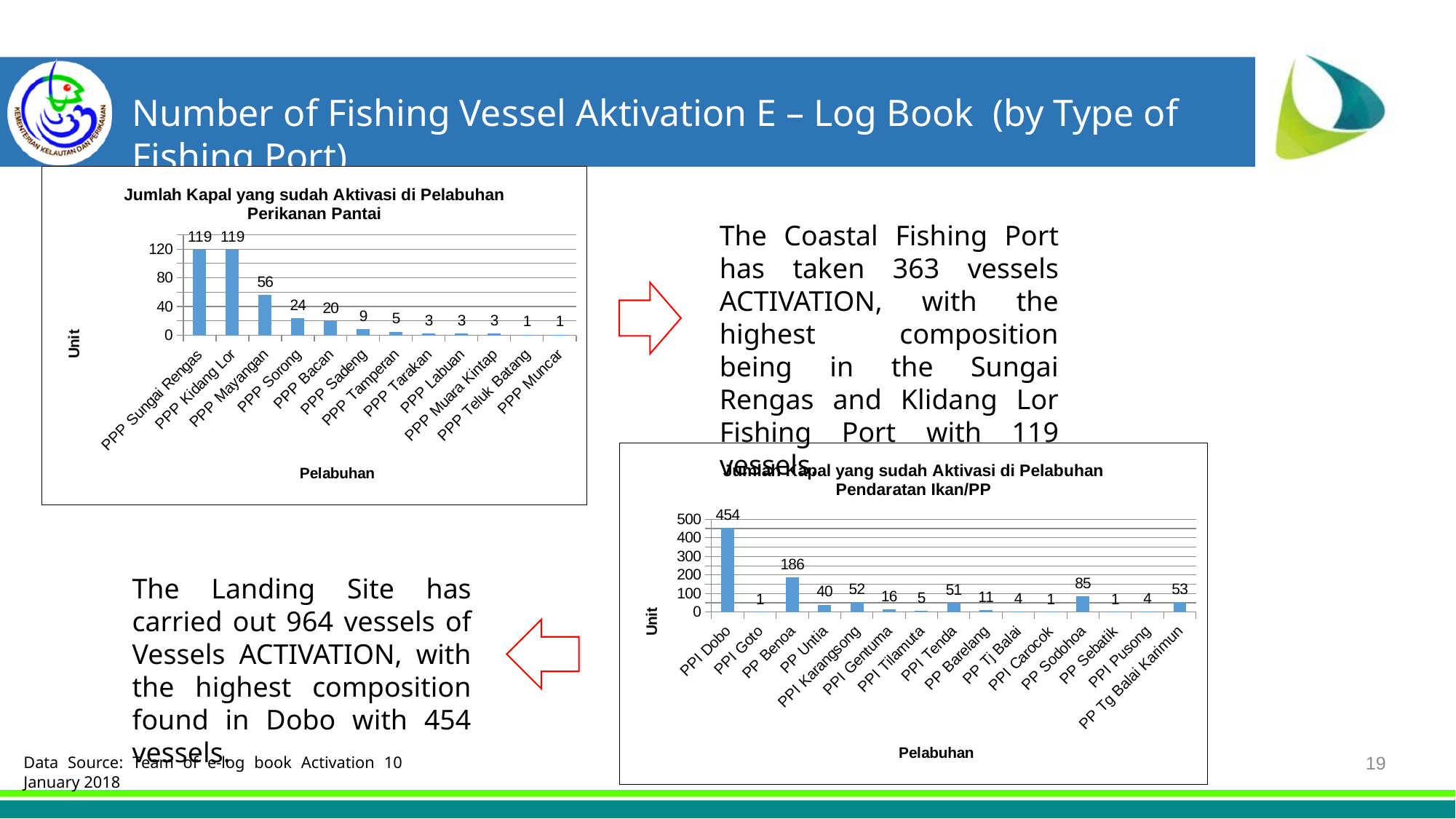
In the chart titled 'Jumlah Kapal yang sudah Aktivasi di Pelabuhan Pendaratan Ikan/PP', what is the value for PP Benoa? 186 How many ports are shown in the chart titled 'Jumlah Kapal yang sudah Aktivasi di Pelabuhan Perikanan Pantai'? 12 What is the x-axis title of the chart titled 'Jumlah Kapal yang sudah Aktivasi di Pelabuhan Pendaratan Ikan/PP'? Pelabuhan In the chart titled 'Jumlah Kapal yang sudah Aktivasi di Pelabuhan Perikanan Pantai', what is the value for PPP Sorong? 24 In the chart titled 'Jumlah Kapal yang sudah Aktivasi di Pelabuhan Perikanan Pantai', what is the value for PPP Mayangan? 56 In the chart titled 'Jumlah Kapal yang sudah Aktivasi di Pelabuhan Perikanan Pantai', what is the difference between PPP Sungai Rengas and PPP Mayangan? 63 In the chart titled 'Jumlah Kapal yang sudah Aktivasi di Pelabuhan Pendaratan Ikan/PP', what is the difference between PPI Dobo and PP Benoa? 268 In the chart titled 'Jumlah Kapal yang sudah Aktivasi di Pelabuhan Perikanan Pantai', which is larger, PPP Bacan or PPP Sadeng? PPP Bacan What type of chart is the chart titled 'Jumlah Kapal yang sudah Aktivasi di Pelabuhan Perikanan Pantai'? Bar chart In the chart titled 'Jumlah Kapal yang sudah Aktivasi di Pelabuhan Pendaratan Ikan/PP', what is the value for PP Sodohoa? 85 How many ports are shown in the chart titled 'Jumlah Kapal yang sudah Aktivasi di Pelabuhan Pendaratan Ikan/PP'? 15 In the chart titled 'Jumlah Kapal yang sudah Aktivasi di Pelabuhan Pendaratan Ikan/PP', which port has the highest value? PPI Dobo